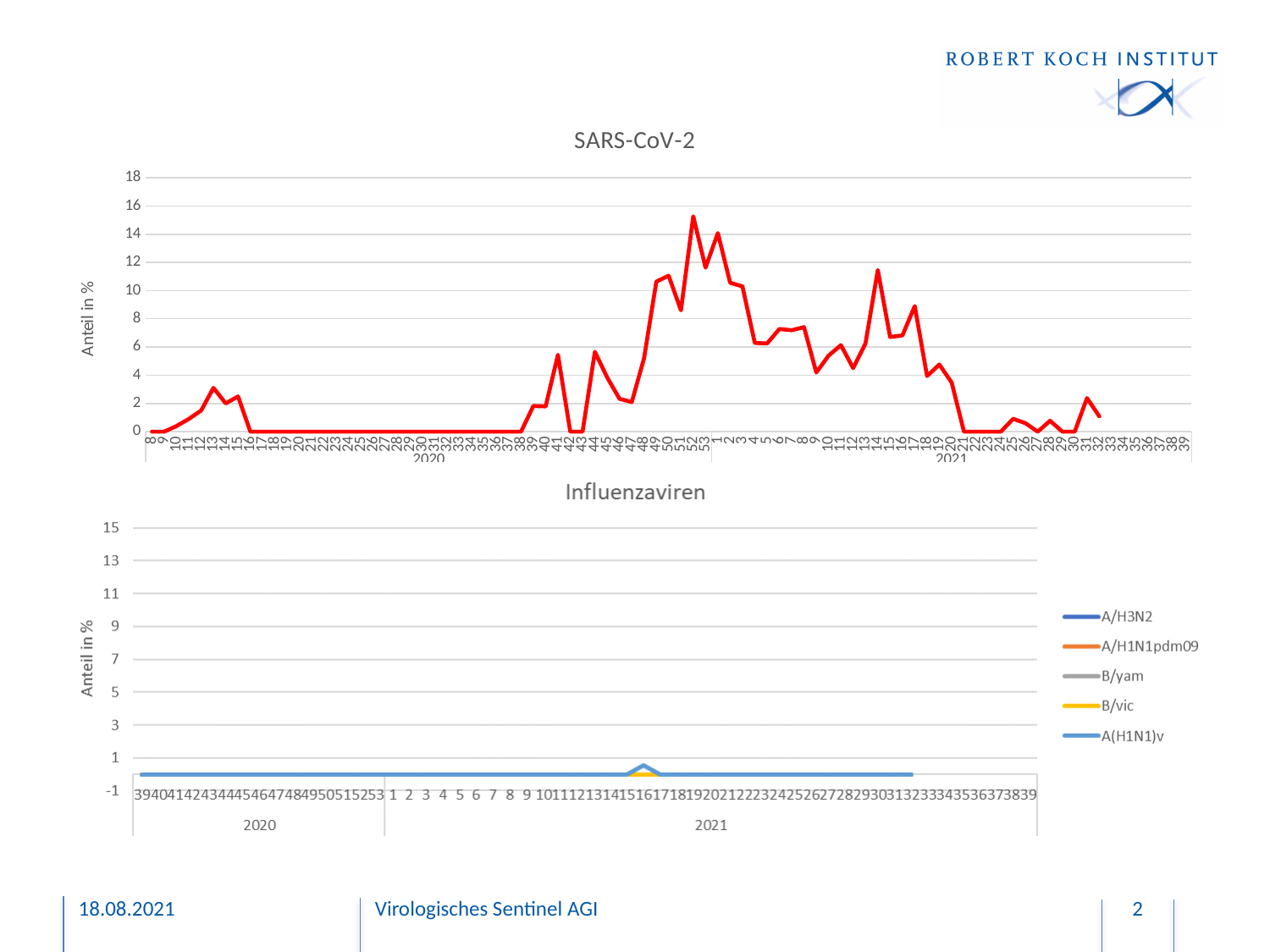
Which series are listed in the legend of the Influenzaviren chart? A/H3N2, A/H1N1pdm09, B/yam, B/vic, A(H1N1)v In the SARS-CoV-2 chart, is the value for week 22 of 2021 greater or less than 2? less In the SARS-CoV-2 chart, do the values generally rise or fall between week 52 of 2020 and week 10 of 2021? fall What kind of chart is the Influenzaviren chart? line chart In the SARS-CoV-2 chart, in which calendar week does the line reach its highest value? week 52 (2020) How many series does the legend of the Influenzaviren chart list? 5 In the SARS-CoV-2 chart, which is larger: the value for week 52 of 2020 or the value for week 14 of 2021? week 52 of 2020 What is the y-axis label of the SARS-CoV-2 chart? Anteil in % In the SARS-CoV-2 chart, is the value for week 14 of 2021 greater or less than 10? greater In the SARS-CoV-2 chart, is the value for week 13 of 2020 greater or less than 2? greater What kind of chart is the SARS-CoV-2 chart? line chart